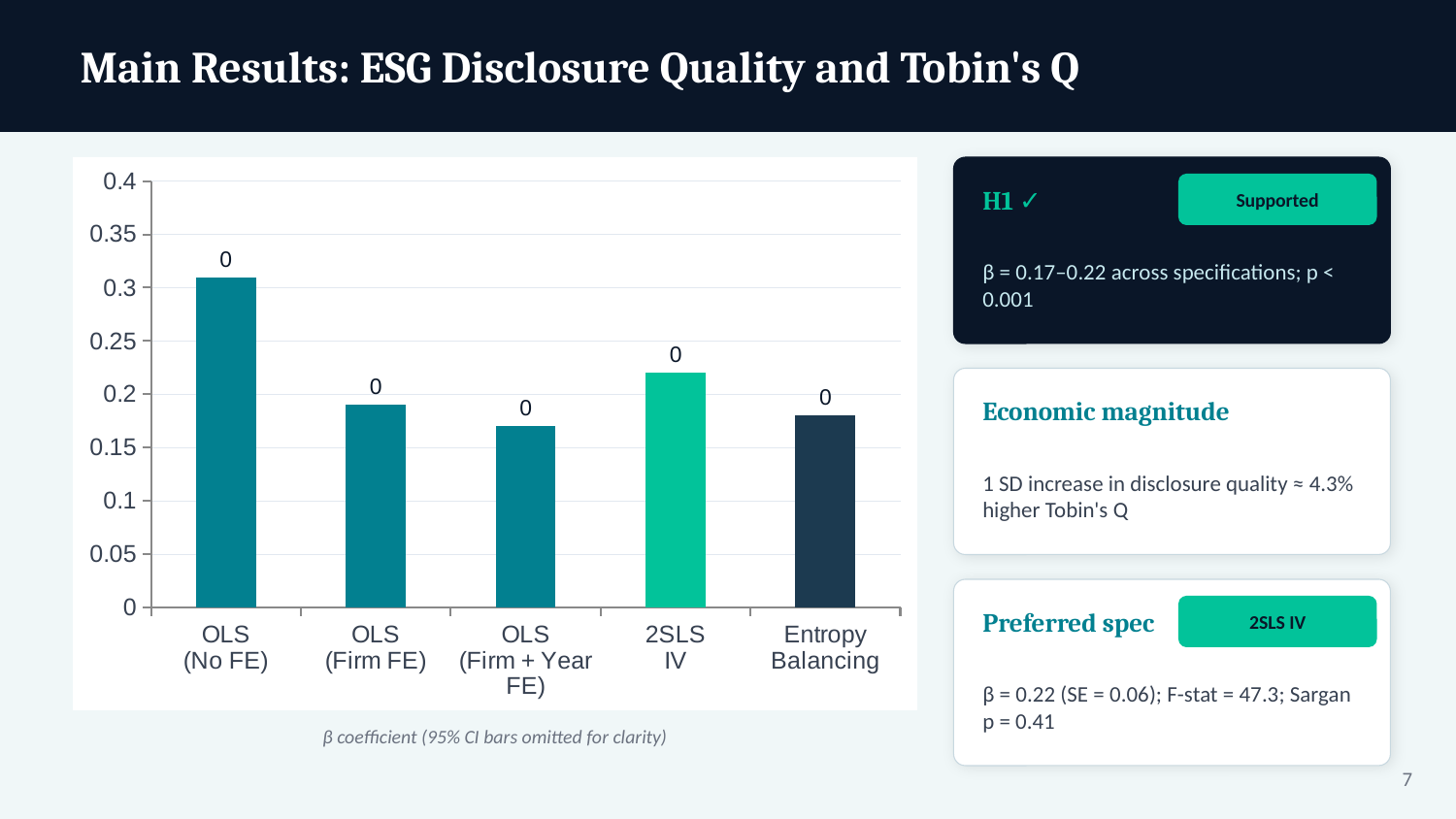
Which is larger, the value for OLS (No FE) or the value for 2SLS IV? OLS (No FE) What is the highest value shown on the chart's vertical axis? 0.4 Which bar in the chart is drawn in a bright green colour, different from the others? 2SLS IV Is the value for OLS (Firm + Year FE) greater or less than 0.2? less How many specifications (bars) are plotted in the chart? 5 Is the value for OLS (No FE) greater or less than 0.25? greater What kind of chart is shown on the slide? bar chart Is the value for 2SLS IV greater or less than 0.2? greater Which is larger, the value for 2SLS IV or the value for OLS (Firm FE)? 2SLS IV Which specification has the highest β coefficient in the chart? OLS (No FE)